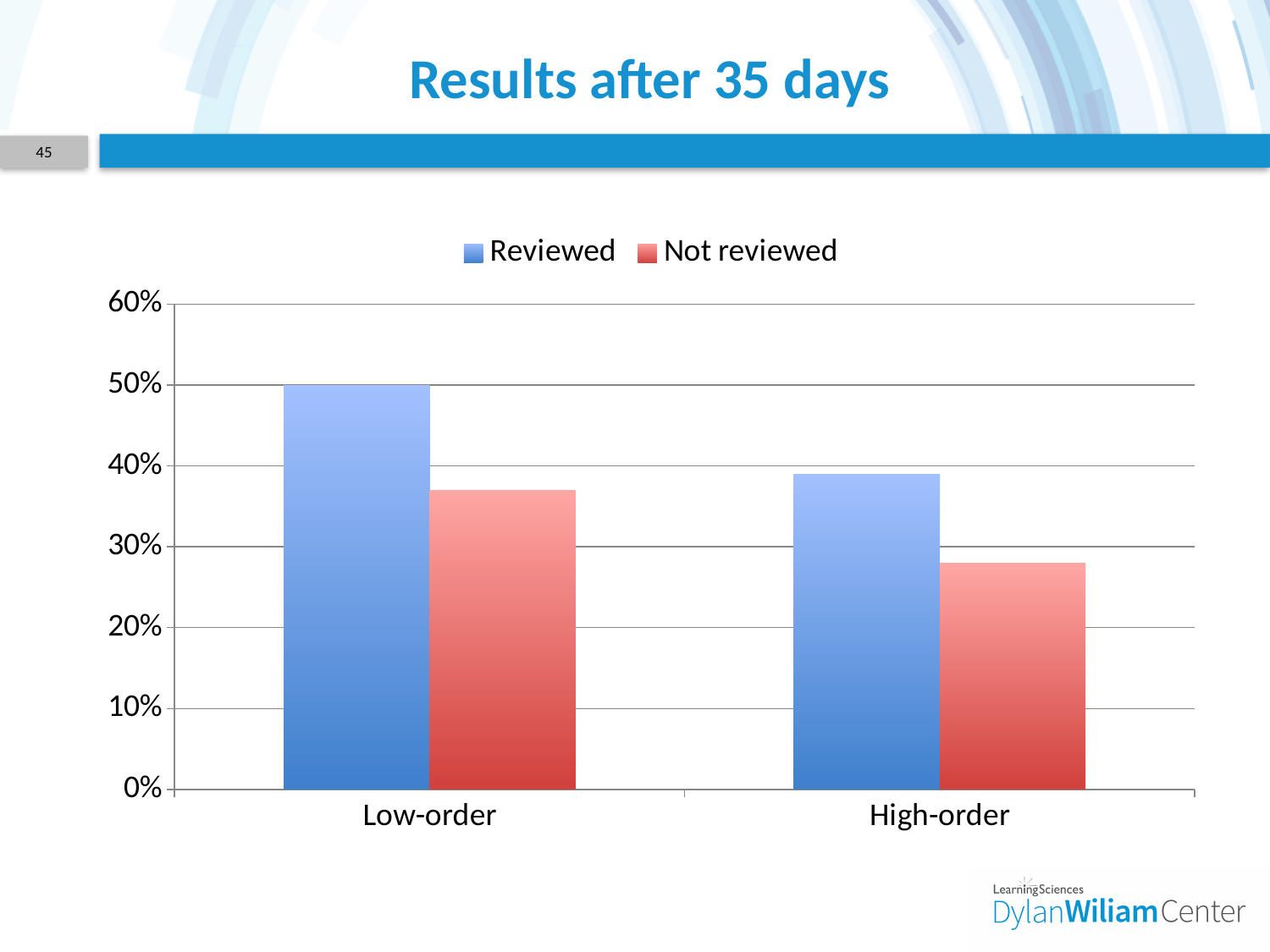
What is the title of the slide containing the chart? Results after 35 days Is the Not reviewed value for Low-order greater or less than 40%? less Is the Not reviewed value for High-order greater or less than 30%? less Is the Reviewed value for High-order greater or less than 30%? greater What is the Reviewed value for Low-order? 50% How many categories are shown on the x axis? 2 For High-order, which is larger: the Reviewed value or the Not reviewed value? Reviewed Which series is shown in red in the legend? Not reviewed Which category has the lowest Not reviewed value? High-order How many series does the legend list? 2 Which category has the highest Reviewed value? Low-order What kind of chart is shown on the slide? bar chart